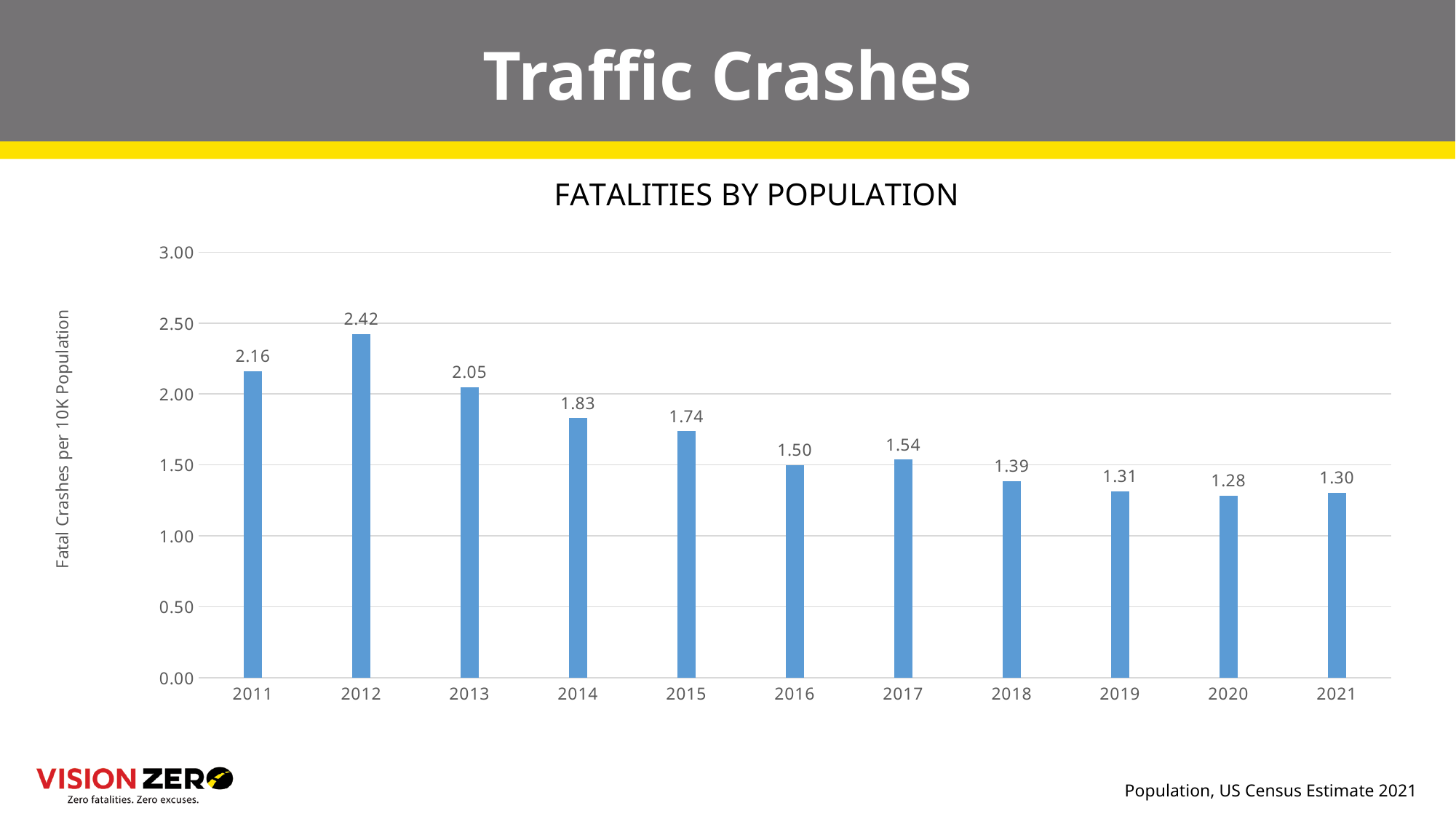
What is the label of the y axis? Fatal Crashes per 10K Population Is the value for 2013 greater or less than 2.00? greater How many years are shown on the x axis? 11 What is the value for 2016? 1.50 What kind of chart is shown? bar chart What is the value for 2012? 2.42 What is the difference between the values for 2011 and 2021? 0.86 What is the value for 2021? 1.30 Which year has the lowest value? 2020 Which year has the highest value? 2012 Which is larger, the value for 2014 or the value for 2017? 2014 Do the values generally rise or fall from 2012 to 2020? fall